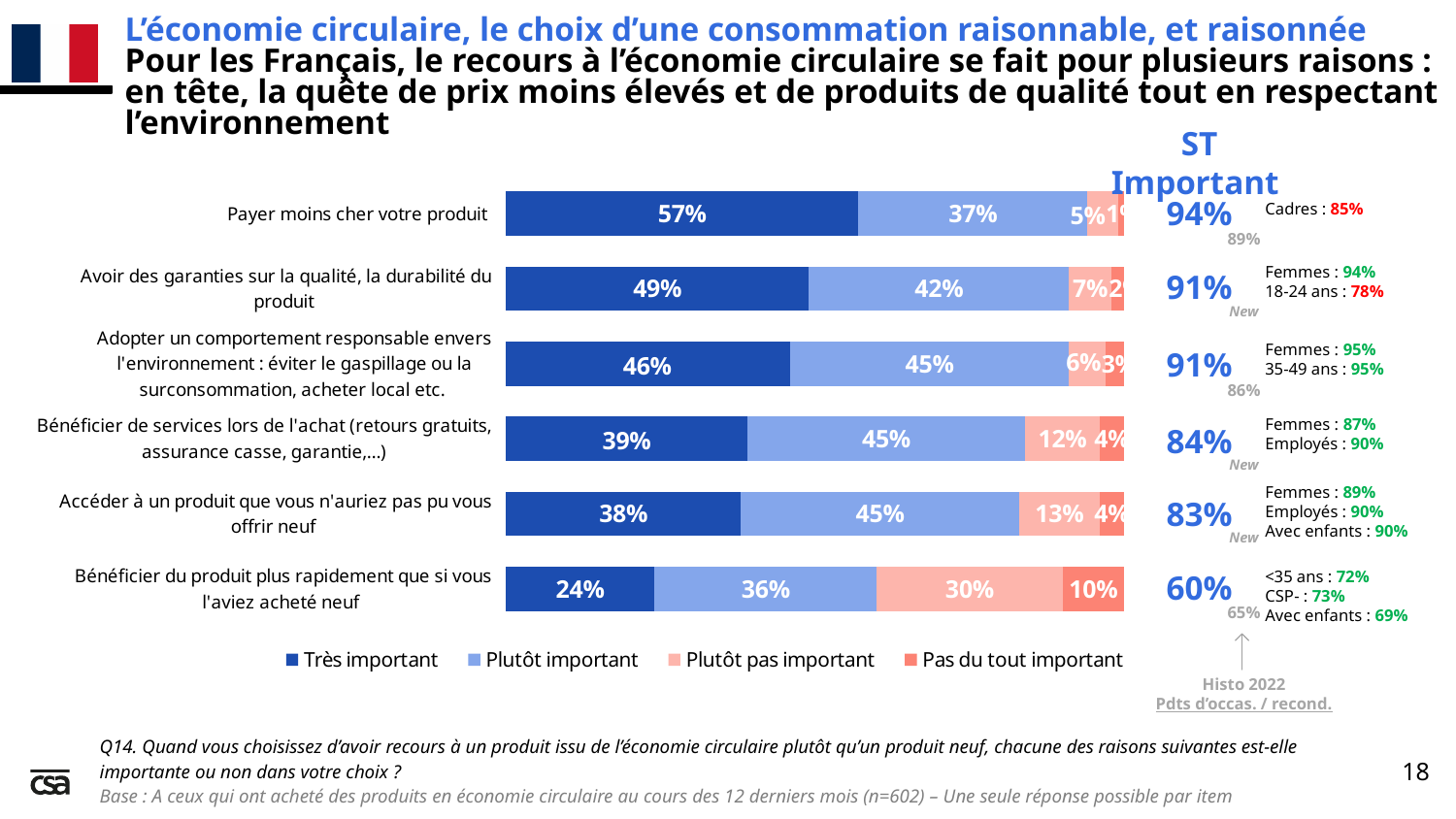
Which category has the lowest 'Très important' value? Bénéficier du produit plus rapidement que si vous l'aviez acheté neuf Which category has the highest 'Très important' value? Payer moins cher votre produit How many series does the legend list? 4 What is the 'ST Important' total for 'Accéder à un produit que vous n'auriez pas pu vous offrir neuf'? 83% How many categories (reasons) are plotted in the chart? 6 What kind of chart is shown on the slide? stacked bar chart What is the 'Plutôt important' value for 'Avoir des garanties sur la qualité, la durabilité du produit'? 42% What is the 'Plutôt pas important' value for 'Bénéficier du produit plus rapidement que si vous l'aviez acheté neuf'? 30% What is the difference between the 'Très important' values for 'Payer moins cher votre produit' and 'Avoir des garanties sur la qualité, la durabilité du produit'? 8% Which legend entry is shown in dark blue? Très important What is the 'Très important' value for 'Payer moins cher votre produit'? 57% Which is larger: the 'Pas du tout important' value for 'Bénéficier du produit plus rapidement que si vous l'aviez acheté neuf' or for 'Bénéficier de services lors de l'achat (retours gratuits, assurance casse, garantie,...)'? Bénéficier du produit plus rapidement que si vous l'aviez acheté neuf